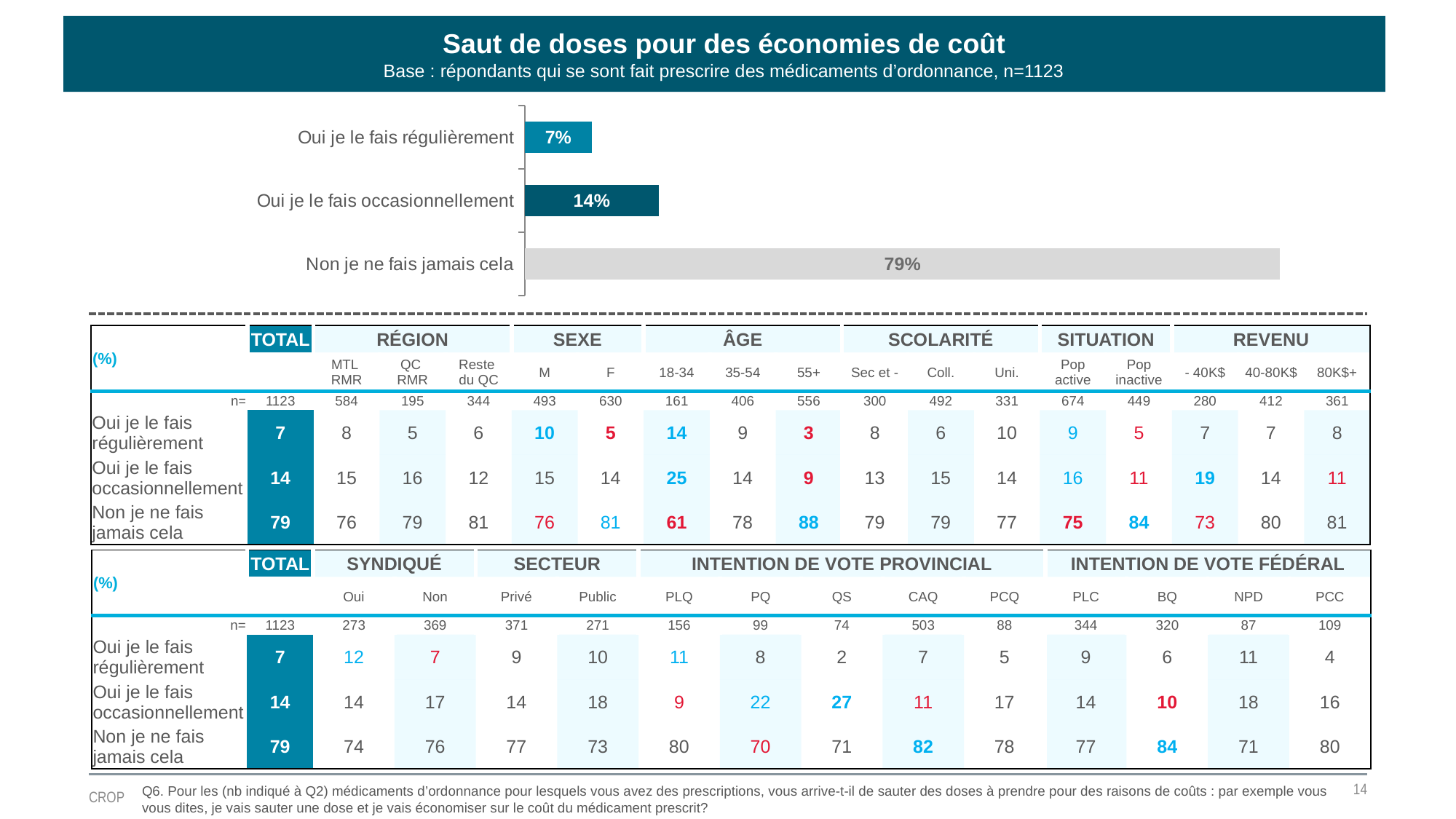
What is the difference between "Non je ne fais jamais cela" and "Oui je le fais occasionnellement"? 65% Which category has the highest value? Non je ne fais jamais cela Which is larger, "Oui je le fais régulièrement" or "Oui je le fais occasionnellement"? Oui je le fais occasionnellement What is the value for "Oui je le fais régulièrement"? 7% What is the difference between "Oui je le fais occasionnellement" and "Oui je le fais régulièrement"? 7% What is the value for "Non je ne fais jamais cela"? 79% What kind of chart is shown on the slide? Bar chart How many categories does the chart show? 3 What is the base size (n) stated under the chart title? n=1123 Which category has the lowest value? Oui je le fais régulièrement What is the title of the chart? Saut de doses pour des économies de coût What is the value for "Oui je le fais occasionnellement"? 14%